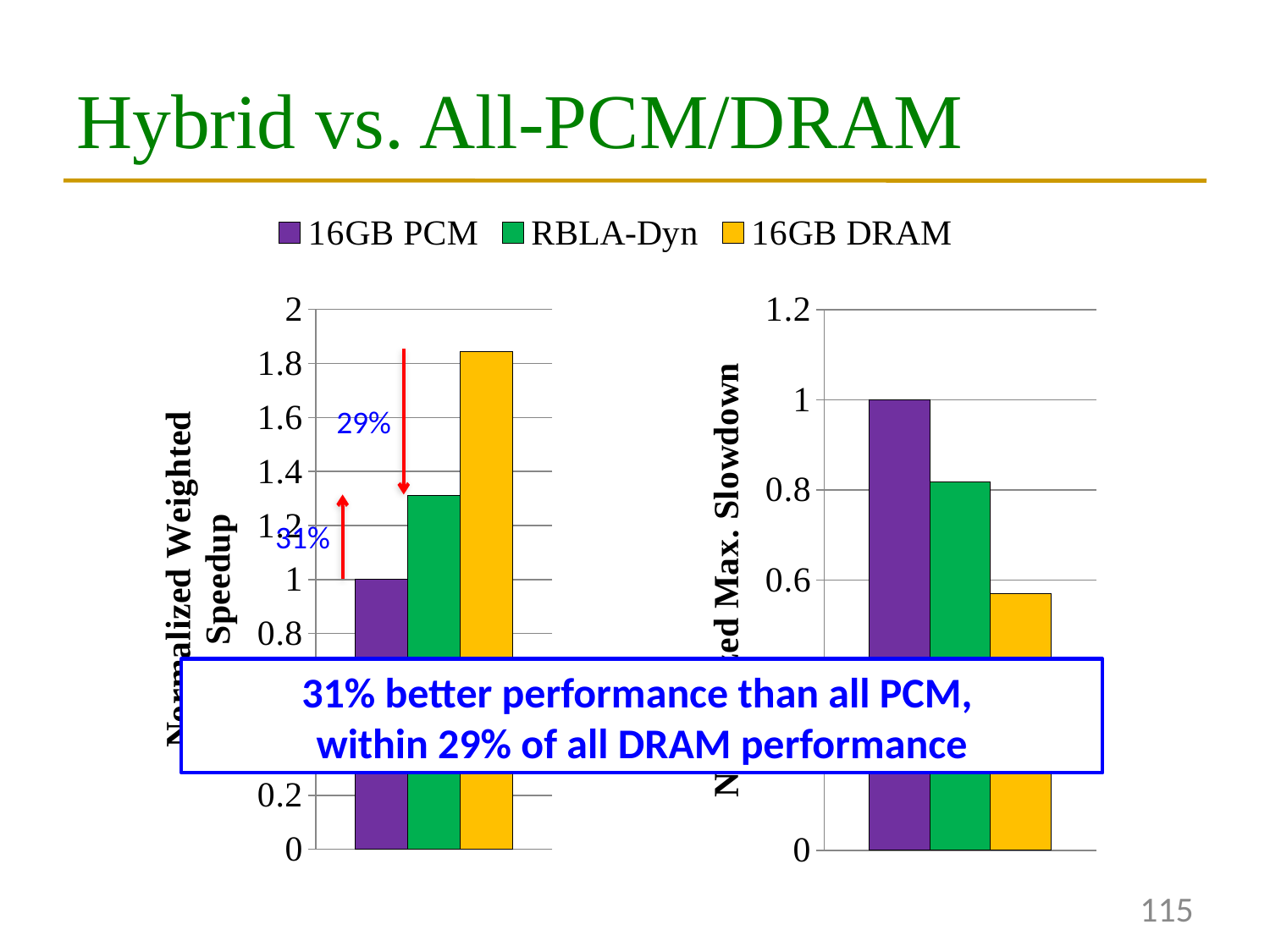
In the left chart (Normalized Weighted Speedup), is the value for RBLA-Dyn greater or less than 1.2? greater How many series does the legend list? 3 In the right chart, which is larger, the value for RBLA-Dyn or the value for 16GB DRAM? RBLA-Dyn In the left chart (Normalized Weighted Speedup), is the value for 16GB DRAM greater or less than 1.6? greater In the right chart, which series has the highest bar? 16GB PCM What kind of chart is the left chart, Normalized Weighted Speedup? bar chart In the left chart (Normalized Weighted Speedup), what is the value for 16GB PCM? 1 In the right chart, which series has the lowest bar? 16GB DRAM In the left chart (Normalized Weighted Speedup), which series has the highest bar? 16GB DRAM In the left chart (Normalized Weighted Speedup), what percentage is annotated between the 16GB PCM and RBLA-Dyn bars? 31% In the left chart (Normalized Weighted Speedup), which series has the lowest bar? 16GB PCM